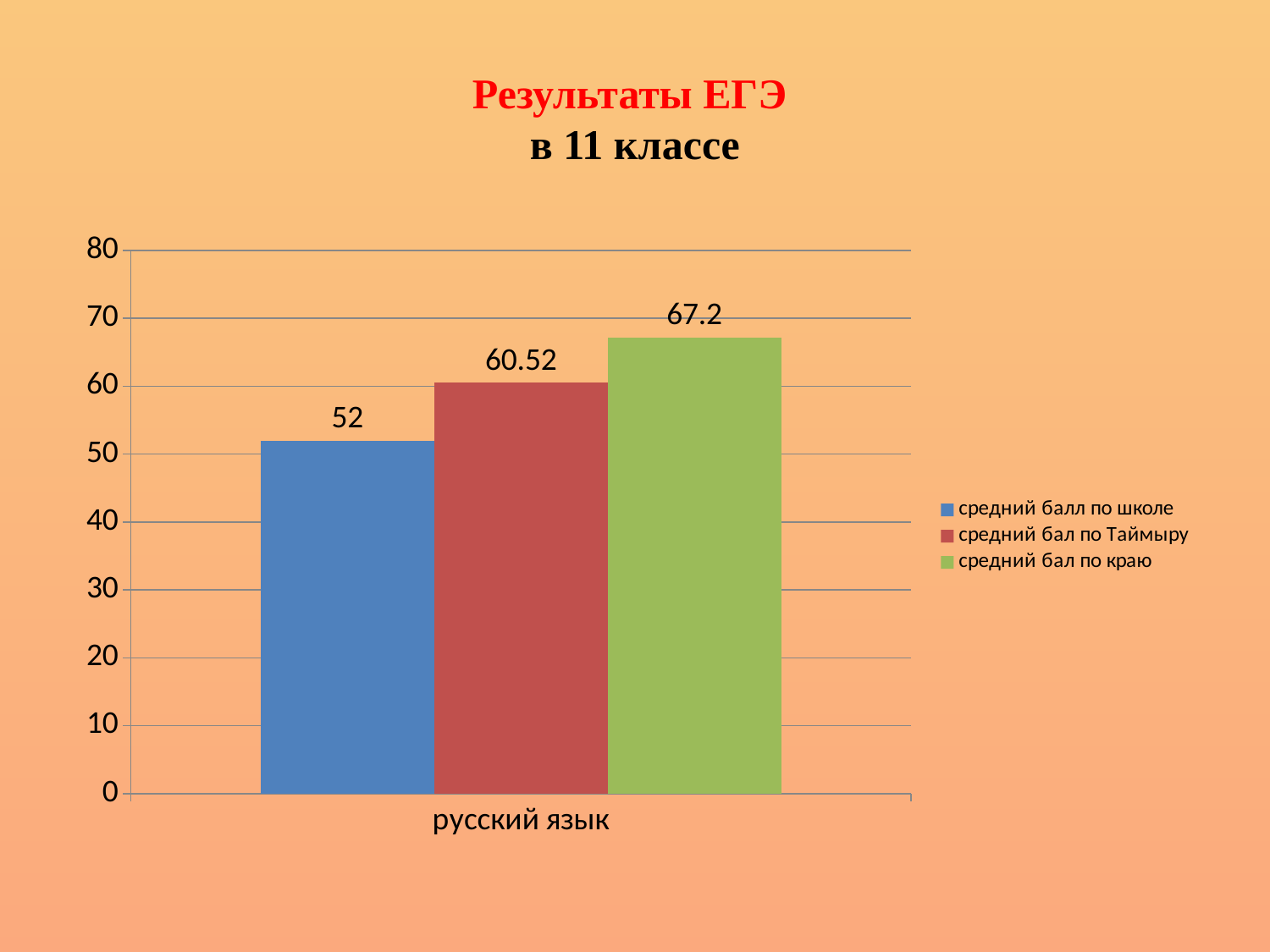
Is the value for 'средний бал по краю' greater or less than 60? greater What is the category label on the x axis? русский язык What is the difference between 'средний бал по краю' and 'средний балл по школе'? 15.2 What kind of chart is shown on the slide? bar chart What is the value for 'средний балл по школе' for русский язык? 52 Which series has the highest value for русский язык? средний бал по краю What is the difference between 'средний бал по Таймыру' and 'средний балл по школе'? 8.52 What is the value for 'средний бал по Таймыру' for русский язык? 60.52 What is the value for 'средний бал по краю' for русский язык? 67.2 How many series does the legend list? 3 Which is larger, 'средний бал по Таймыру' or 'средний балл по школе'? средний бал по Таймыру Which series has the lowest value for русский язык? средний балл по школе